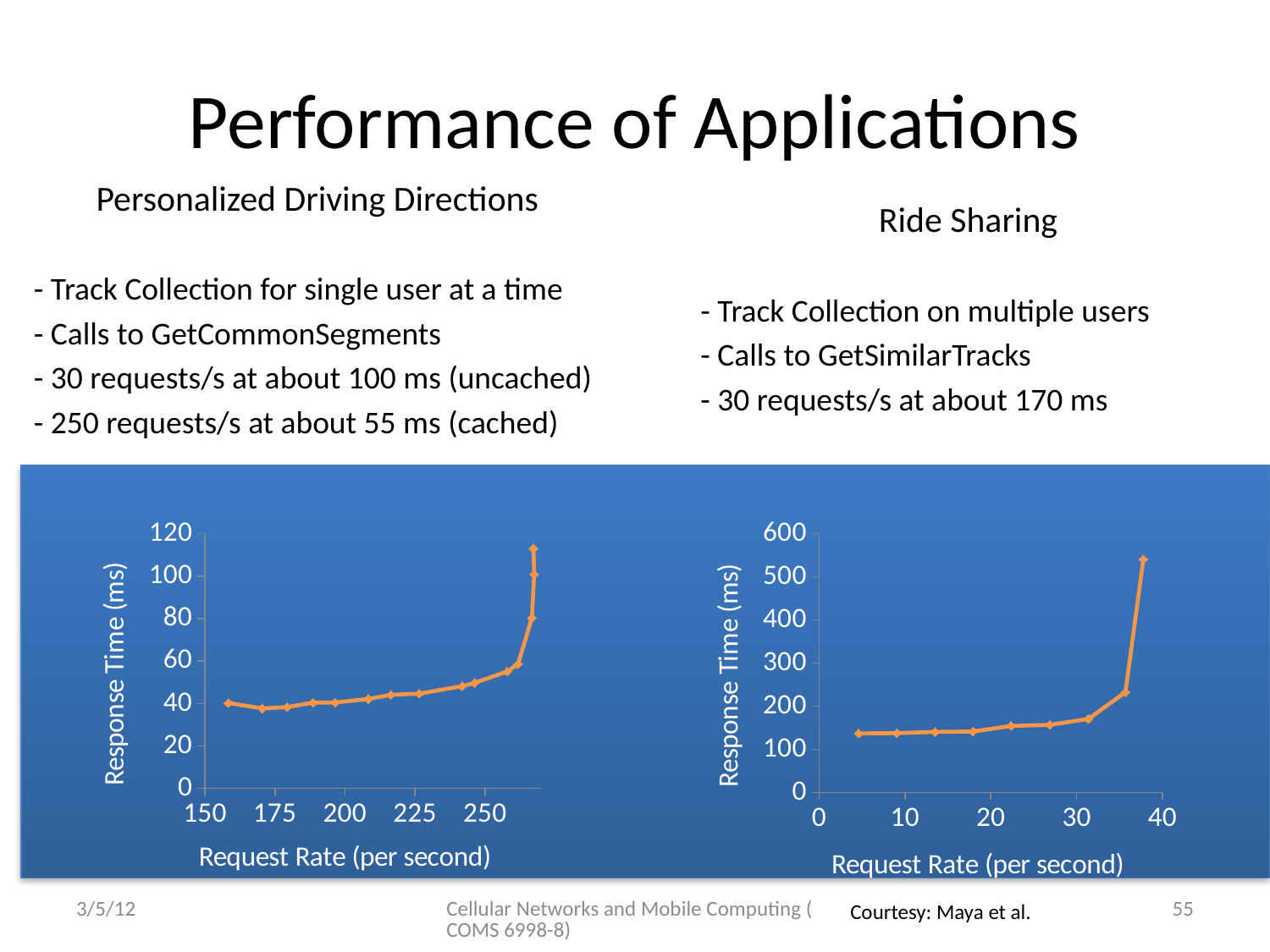
In the left chart, is the highest plotted response time greater or less than 100? greater What kind of chart is the left chart on the slide? line chart What is the x-axis title of the right chart? Request Rate (per second) In the right chart, is the highest plotted response time greater or less than 500? greater What kind of chart is the right chart on the slide? line chart In the right chart, is the lowest plotted response time greater or less than 100? greater In the right chart, does the response time rise or fall as the request rate increases toward the right end of the x axis? rise What is the y-axis title of the left chart? Response Time (ms) In the left chart, does the response time rise or fall as the request rate increases toward the right end of the x axis? rise